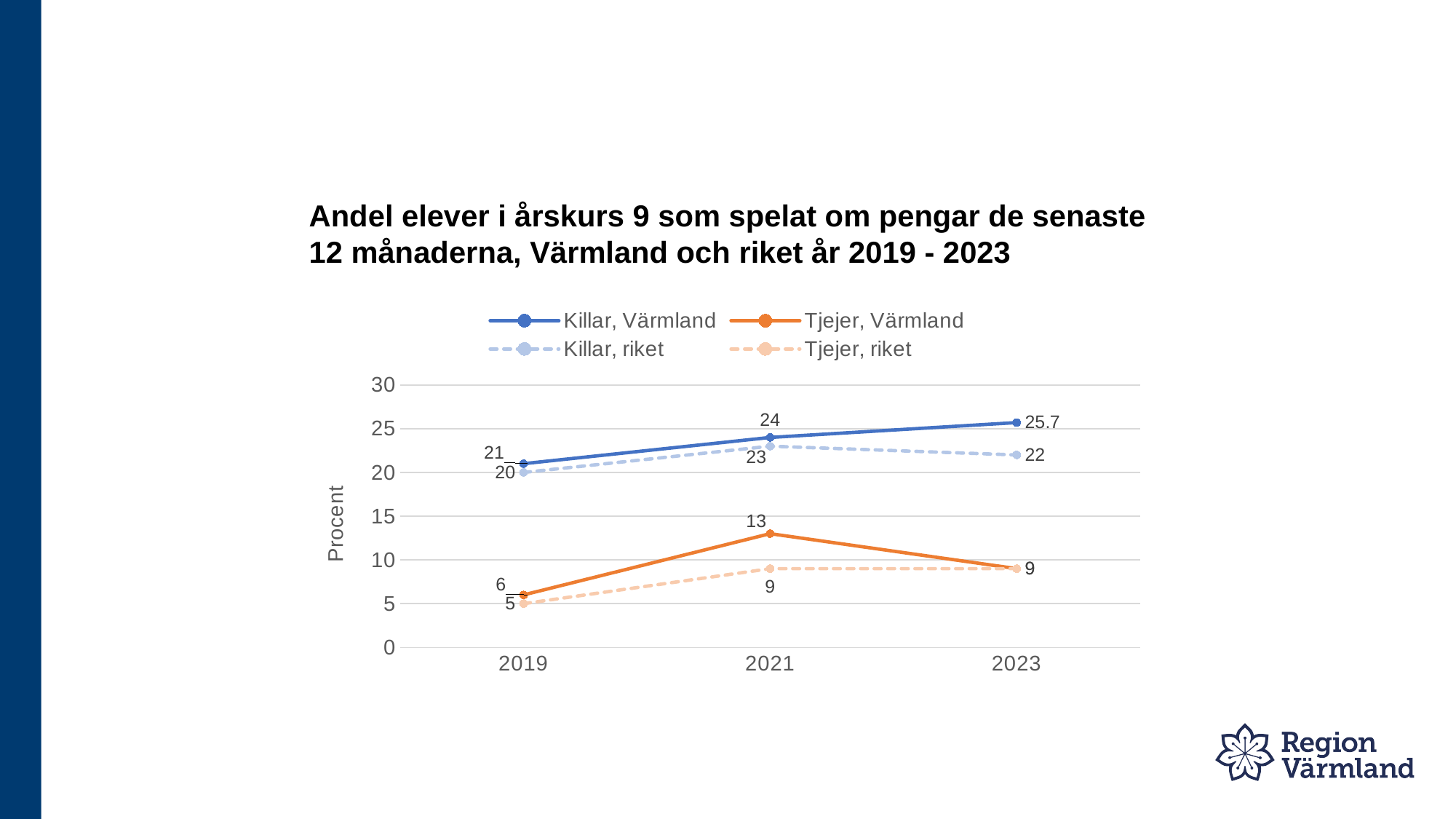
In which year is the value for Killar, Värmland highest? 2023 Which is larger in 2019: Tjejer, Värmland or Tjejer, riket? Tjejer, Värmland What is the value for Killar, Värmland in 2023? 25.7 How many years are plotted on the x axis? 3 What is the value for Tjejer, riket in 2021? 9 What is the value for Killar, riket in 2019? 20 Does the value for Killar, Värmland rise or fall from 2019 to 2023? rise How many series does the legend list? 4 What kind of chart is shown on the slide? line chart What is the difference between Killar, Värmland and Killar, riket in 2021? 1 What is the value for Tjejer, Värmland in 2021? 13 In which year is the value for Tjejer, Värmland lowest? 2019